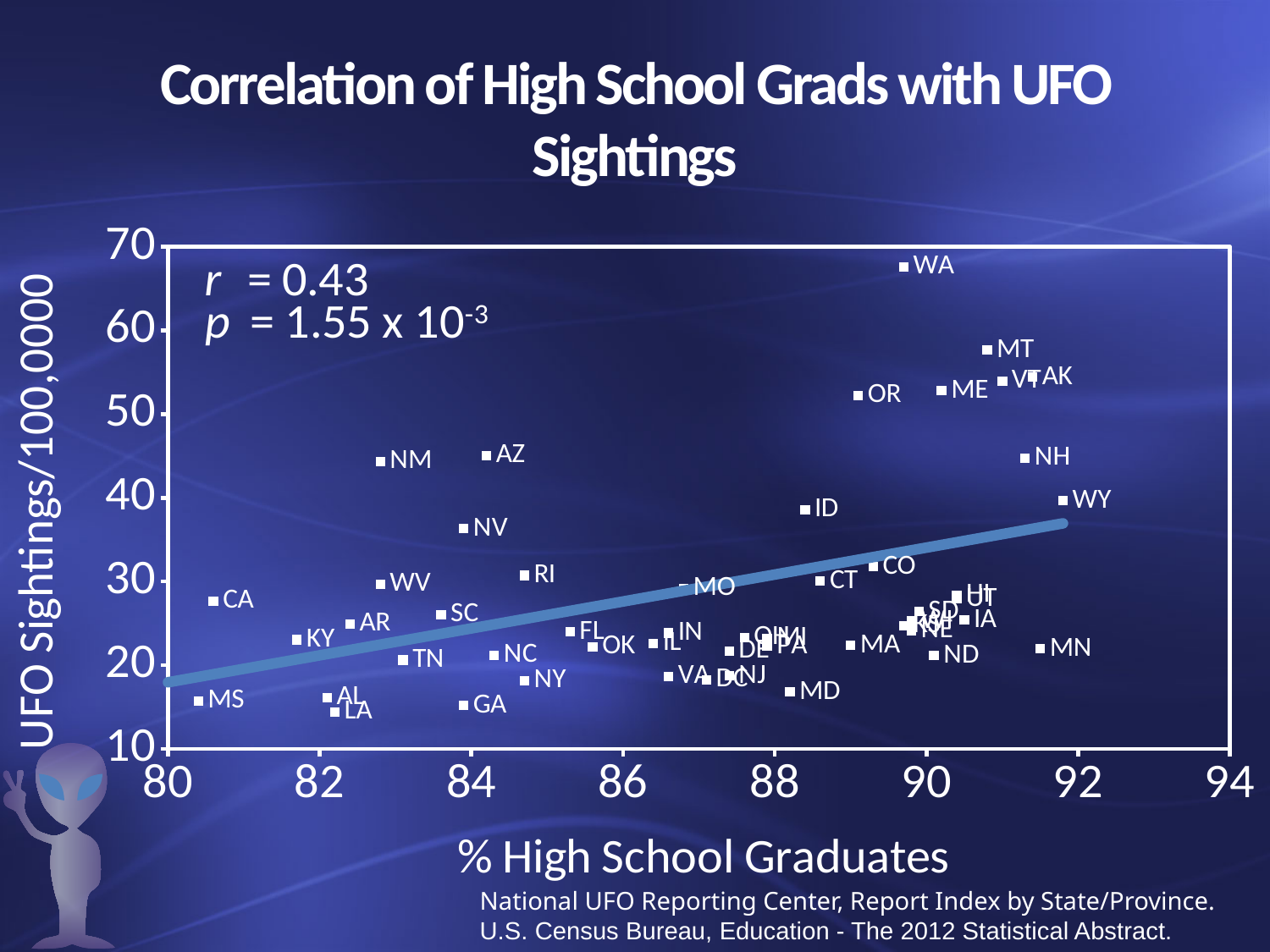
What correlation coefficient r is printed on the chart? 0.43 Does the trend line show UFO sightings rising or falling as % High School Graduates increases? rising Which has a higher UFO sightings value, OR or ID? OR Which state has the highest UFO sightings value on the chart? WA Which state has the lowest % High School Graduates value on the chart? MS Is the UFO sightings value for WA greater or less than 60? greater What kind of chart is shown on the slide? scatter chart Is the UFO sightings value for MS greater or less than 20? less Which has a higher UFO sightings value, WA or MT? WA Is the UFO sightings value for NM greater or less than 40? greater